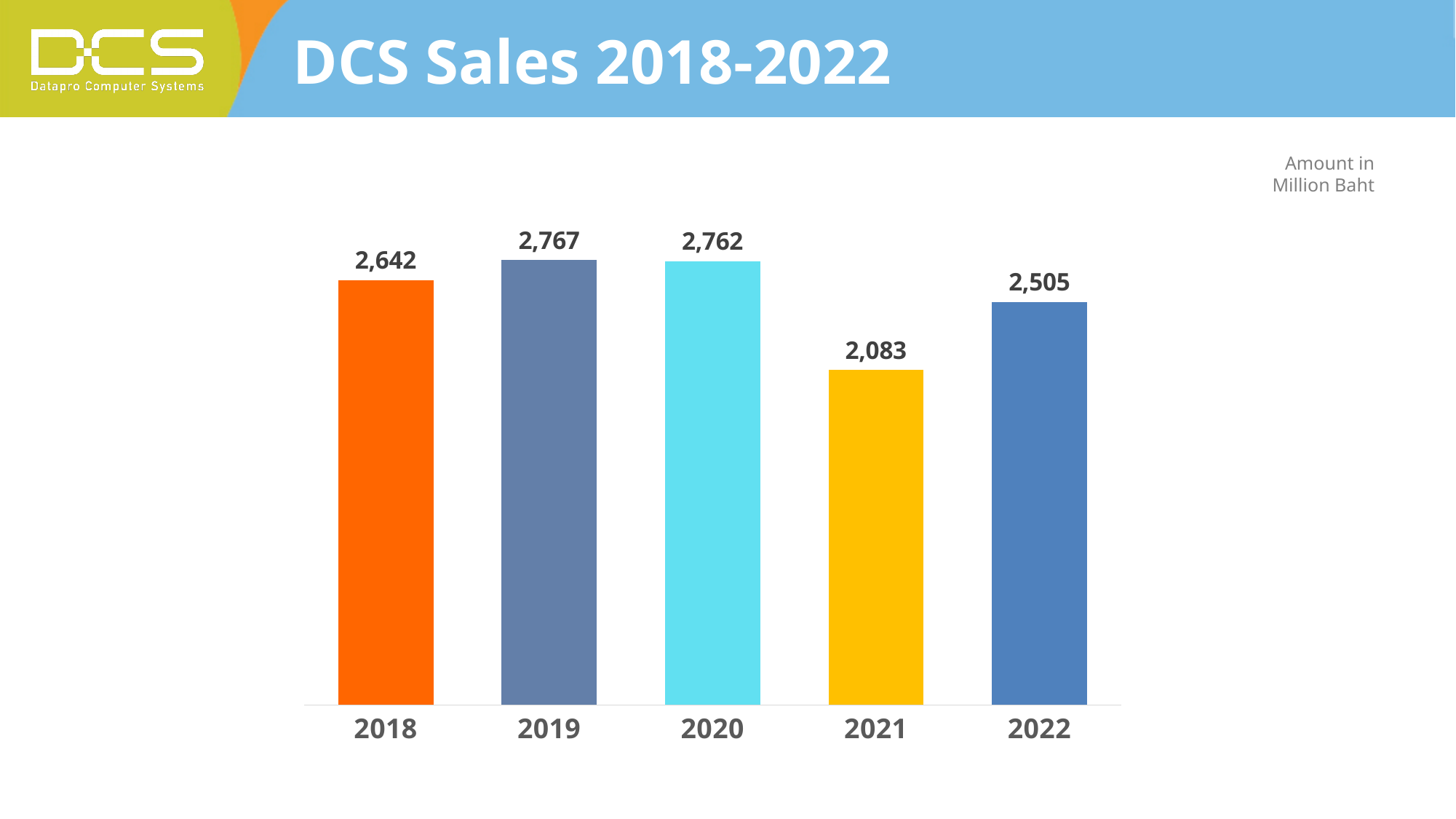
What is the difference between the sales in 2019 and 2021? 684 In what unit are the amounts on the chart expressed? Million Baht What kind of chart is shown on the slide? Bar chart Which year has the lowest sales? 2021 What is the sales value for 2022? 2,505 How many years are shown on the chart? 5 Which year has the highest sales? 2019 What is the sales value for 2021? 2,083 Which year has higher sales, 2018 or 2022? 2018 What is the difference between the sales in 2018 and 2022? 137 Do sales rise or fall from 2020 to 2021? Fall What is the sales value for 2018? 2,642